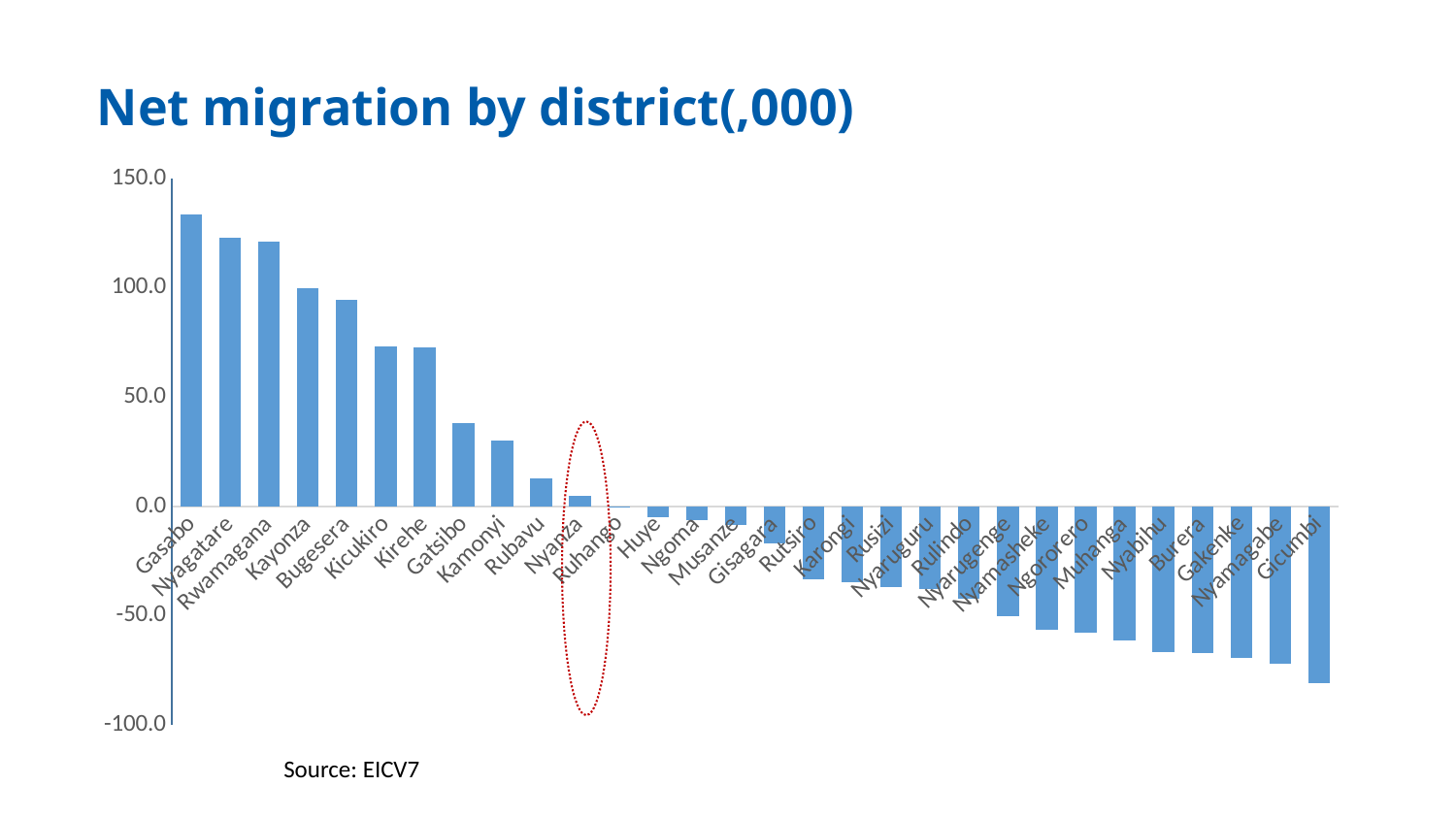
Which district has the lowest net migration? Gicumbi Is the value for Gasabo greater or less than 100.0? greater Which is larger, the value for Gasabo or the value for Nyagatare? Gasabo What is the title of the chart? Net migration by district(,000) Is the value for Kicukiro greater or less than 50.0? greater Is the value for Gicumbi greater or less than -50.0? less Which district's bar is circled with a red dotted ellipse? Nyanza What kind of chart is shown on the slide? Bar chart Which district has the highest net migration? Gasabo How many districts are shown on the x axis? 30 Do the values rise or fall moving from left to right along the x axis? fall